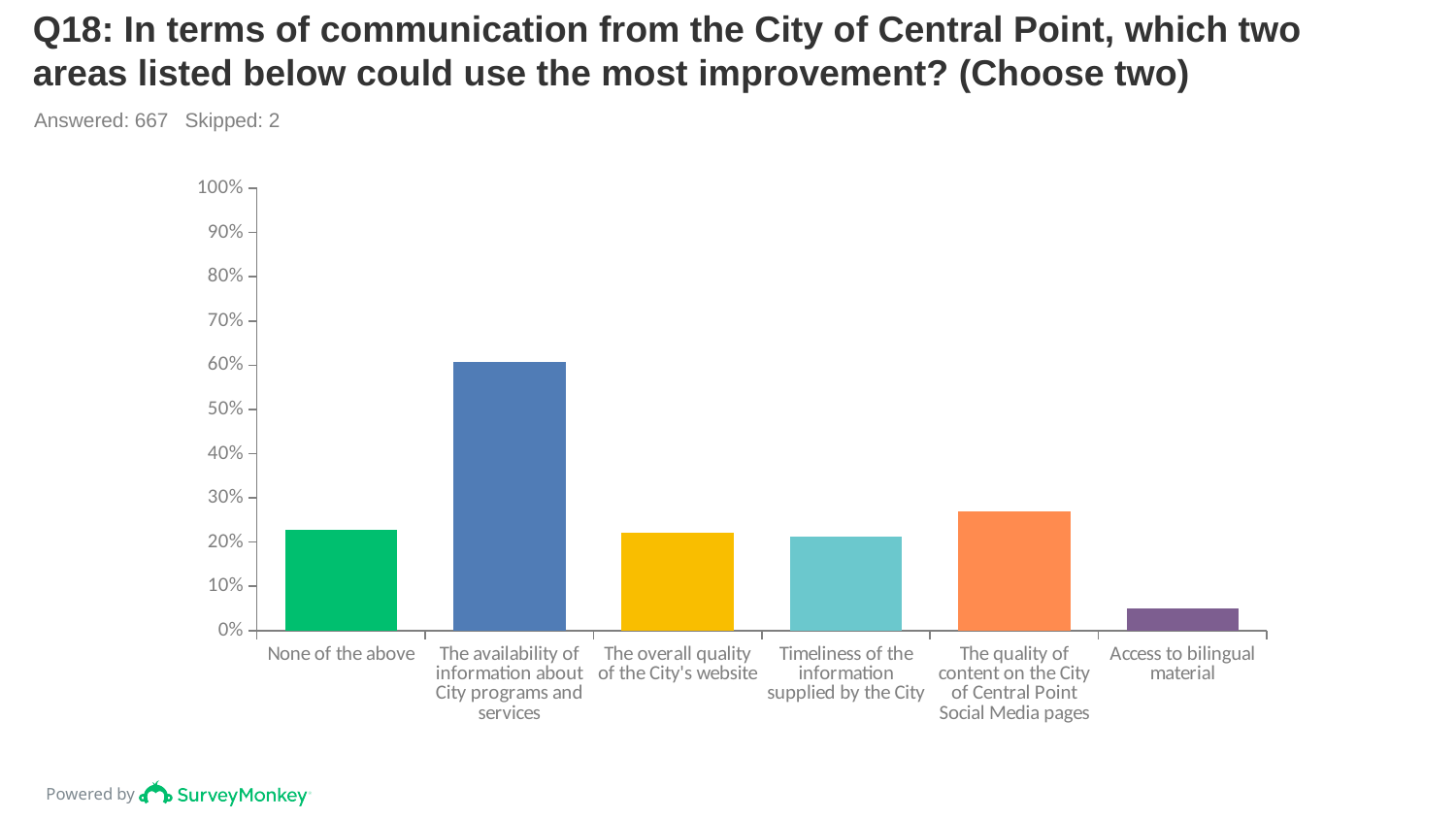
Is the value for 'Access to bilingual material' greater or less than 10%? less Which category has the lowest value in the chart? Access to bilingual material Is the value for 'The quality of content on the City of Central Point Social Media pages' greater or less than 20%? greater How many categories are shown on the x axis of the chart? 6 Is the value for 'The availability of information about City programs and services' greater or less than 50%? greater Which is larger: the value for 'None of the above' or the value for 'Access to bilingual material'? None of the above How many respondents answered the question shown on the slide? 667 Which category has the highest value in the chart? The availability of information about City programs and services What kind of chart is shown on the slide? bar chart What is the maximum value shown on the y axis of the chart? 100% Which is larger: the value for 'The quality of content on the City of Central Point Social Media pages' or the value for 'Timeliness of the information supplied by the City'? The quality of content on the City of Central Point Social Media pages